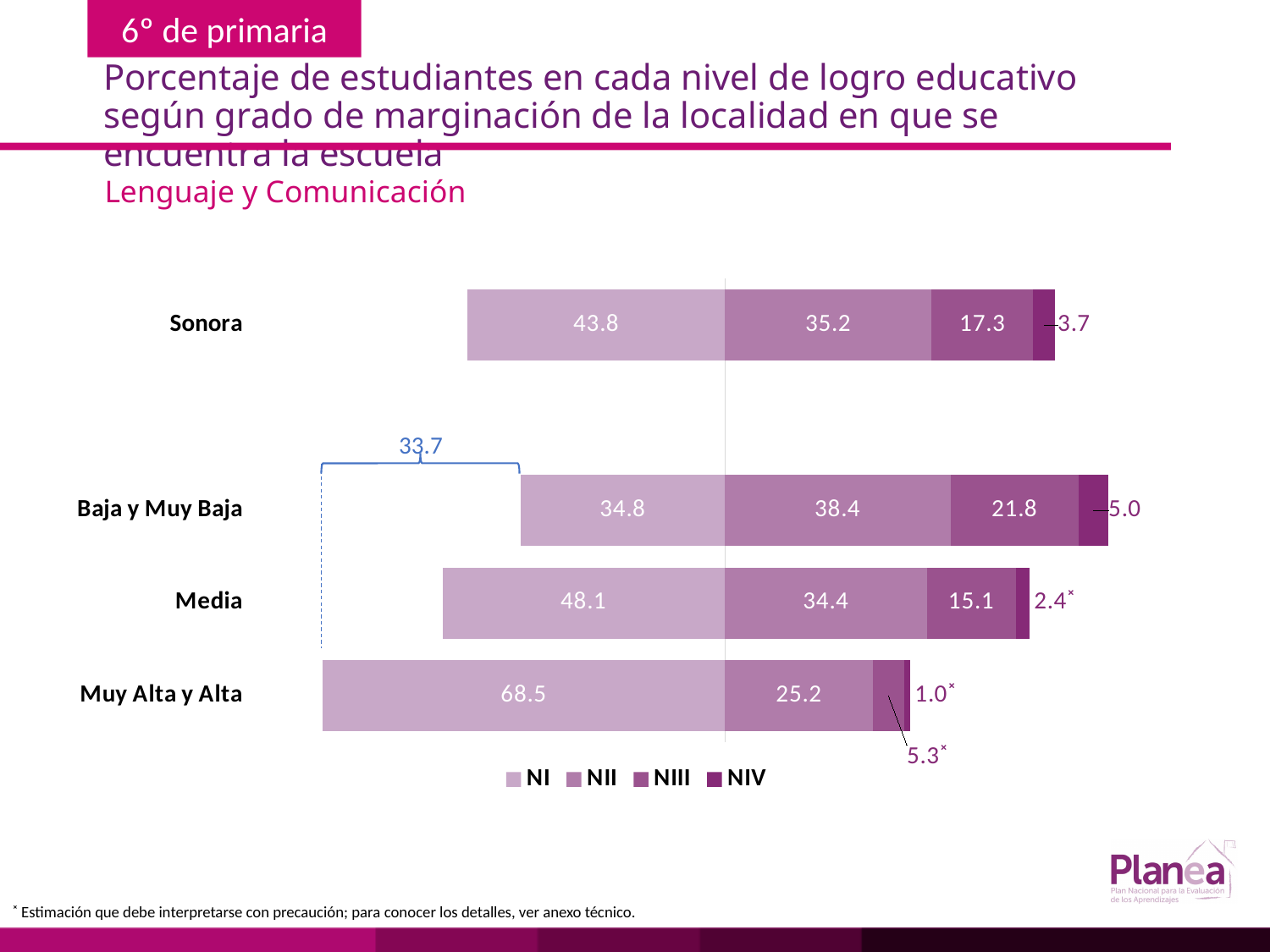
Which category has the lowest NIII value? Muy Alta y Alta How many series does the legend list? 4 What is the difference between the NI value for Muy Alta y Alta and the NI value for Baja y Muy Baja? 33.7 What type of chart is shown on the slide? stacked bar chart Which category has the highest NI value? Muy Alta y Alta What is the NI value for Sonora? 43.8 What is the NI value for Muy Alta y Alta? 68.5 What is the NIII value for Media? 15.1 How many categories (bars) are plotted in the chart? 4 Which is larger, the NII value for Sonora or the NII value for Media? Sonora What is the NIV value for Sonora? 3.7 What is the NII value for Baja y Muy Baja? 38.4